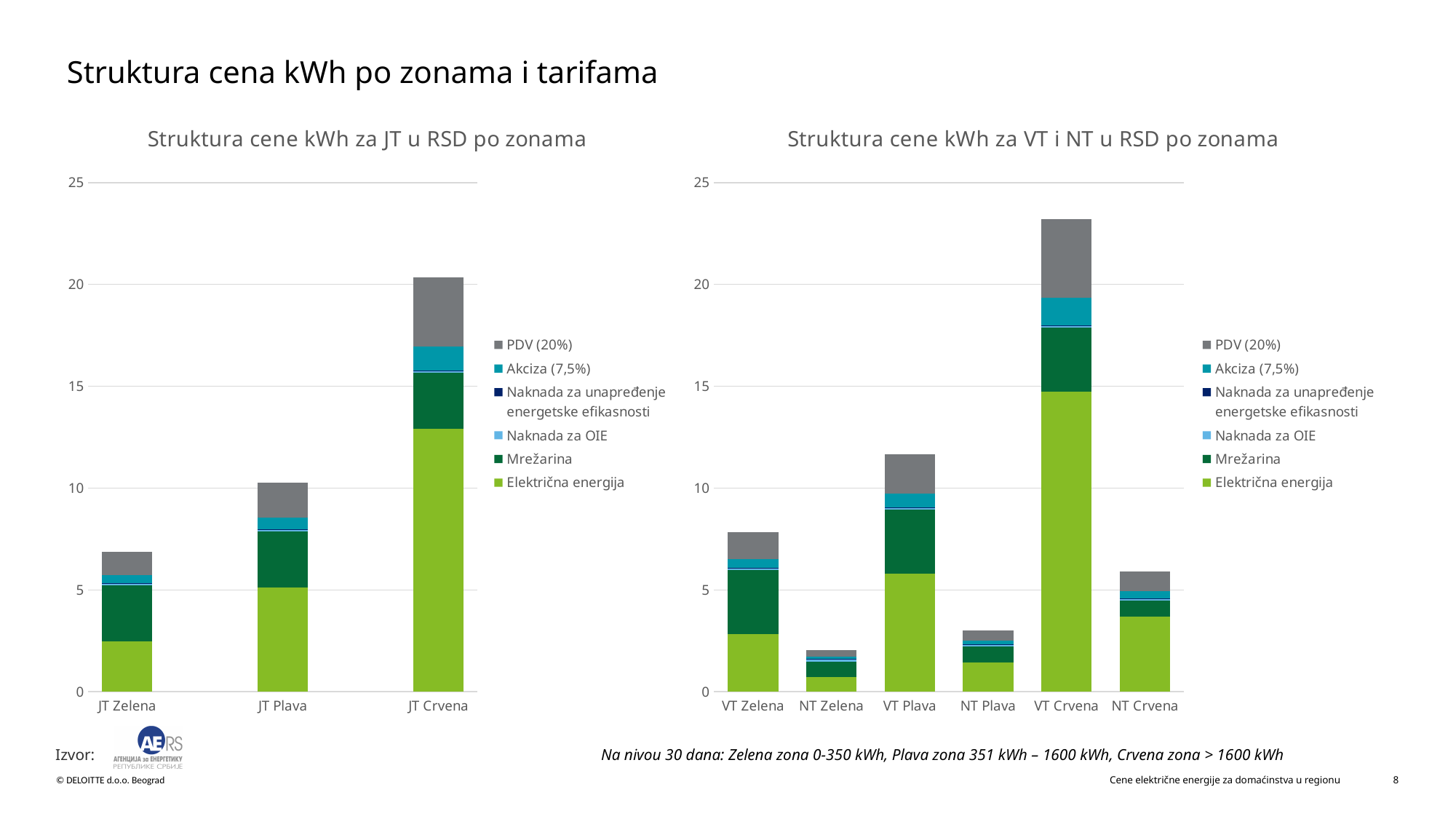
In the left chart (JT), how many zone categories are shown on the x axis? 3 In the left chart (JT), which zone has the highest total bar? JT Crvena How many series does the legend of the right chart (VT i NT) list? 6 In the left chart (JT), is the total bar for JT Zelena greater or less than 10? less In the right chart (VT i NT), which total bar is larger: VT Plava or NT Crvena? VT Plava In the right chart (VT i NT), which category has the lowest total bar? NT Zelena In the right chart (VT i NT), how many categories are shown on the x axis? 6 In the right chart (VT i NT), is the total bar for VT Crvena greater or less than 20? greater What kind of chart is the left chart titled 'Struktura cene kWh za JT u RSD po zonama'? stacked bar chart In the right chart (VT i NT), which category has the highest total bar? VT Crvena In the left chart (JT), which zone has the lowest total bar? JT Zelena Which legend entry in the left chart (JT) is shown in light green? Električna energija